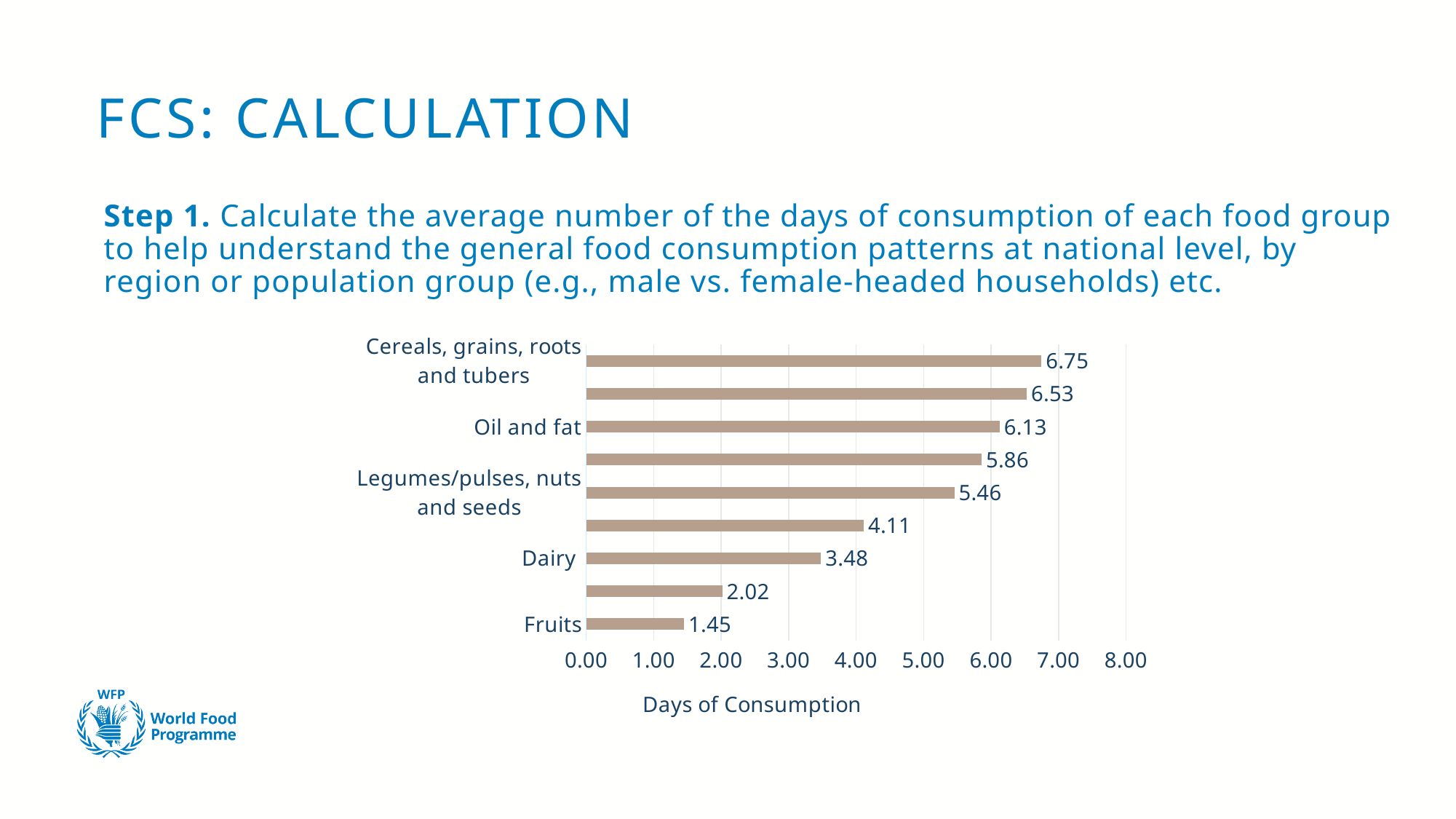
What is the value for Oil and fat? 6.13 What is the value for Fruits? 1.45 What is the difference between the values for Cereals, grains, roots and tubers and Fruits? 5.30 What is the value for Legumes/pulses, nuts and seeds? 5.46 Is the value for Dairy greater or less than 4.00? less What kind of chart is shown on the slide? bar chart Which labelled food group has the highest days of consumption? Cereals, grains, roots and tubers Which is larger, the value for Oil and fat or the value for Dairy? Oil and fat What is the value for Cereals, grains, roots and tubers? 6.75 Which labelled food group has the lowest days of consumption? Fruits What is the value for Dairy? 3.48 How many bars are plotted in the chart? 9